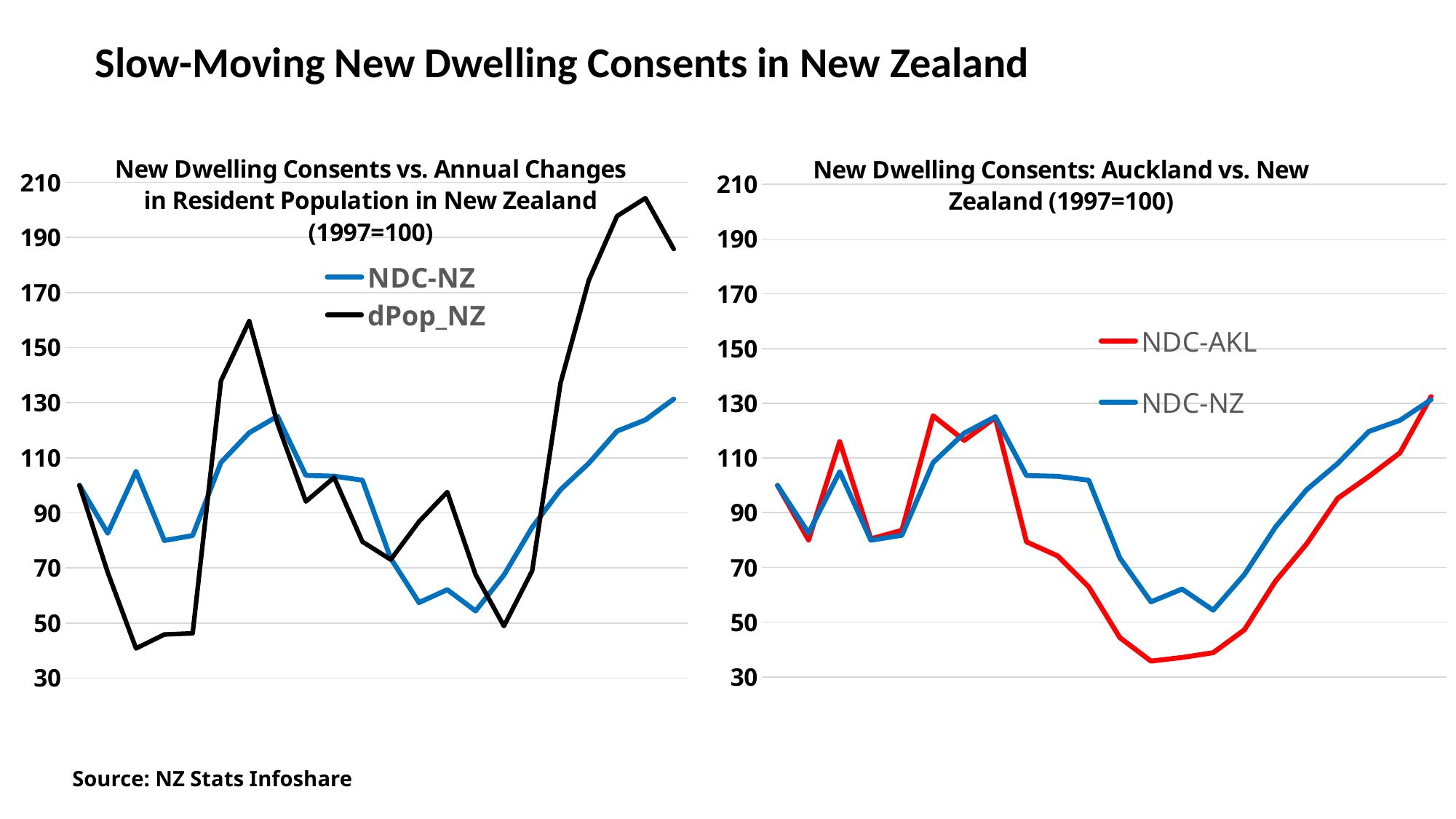
How many series does the legend of the right chart list? 2 What is the source cited at the bottom of the slide? NZ Stats Infoshare In the left chart, is the lowest value reached by dPop_NZ greater or less than 50? less What kind of chart is the left chart, 'New Dwelling Consents vs. Annual Changes in Resident Population in New Zealand (1997=100)'? line chart In the right chart, which series falls to the lower minimum, NDC-AKL or NDC-NZ? NDC-AKL In the left chart, which series reaches the higher peak value, NDC-NZ or dPop_NZ? dPop_NZ How many series does the legend of the left chart list? 2 In the right chart, is the lowest value reached by NDC-AKL greater or less than 50? less What kind of chart is the right chart, 'New Dwelling Consents: Auckland vs. New Zealand (1997=100)'? line chart In the right chart, what colour is the NDC-AKL line? red In the right chart, is the final value of NDC-NZ greater or less than 110? greater